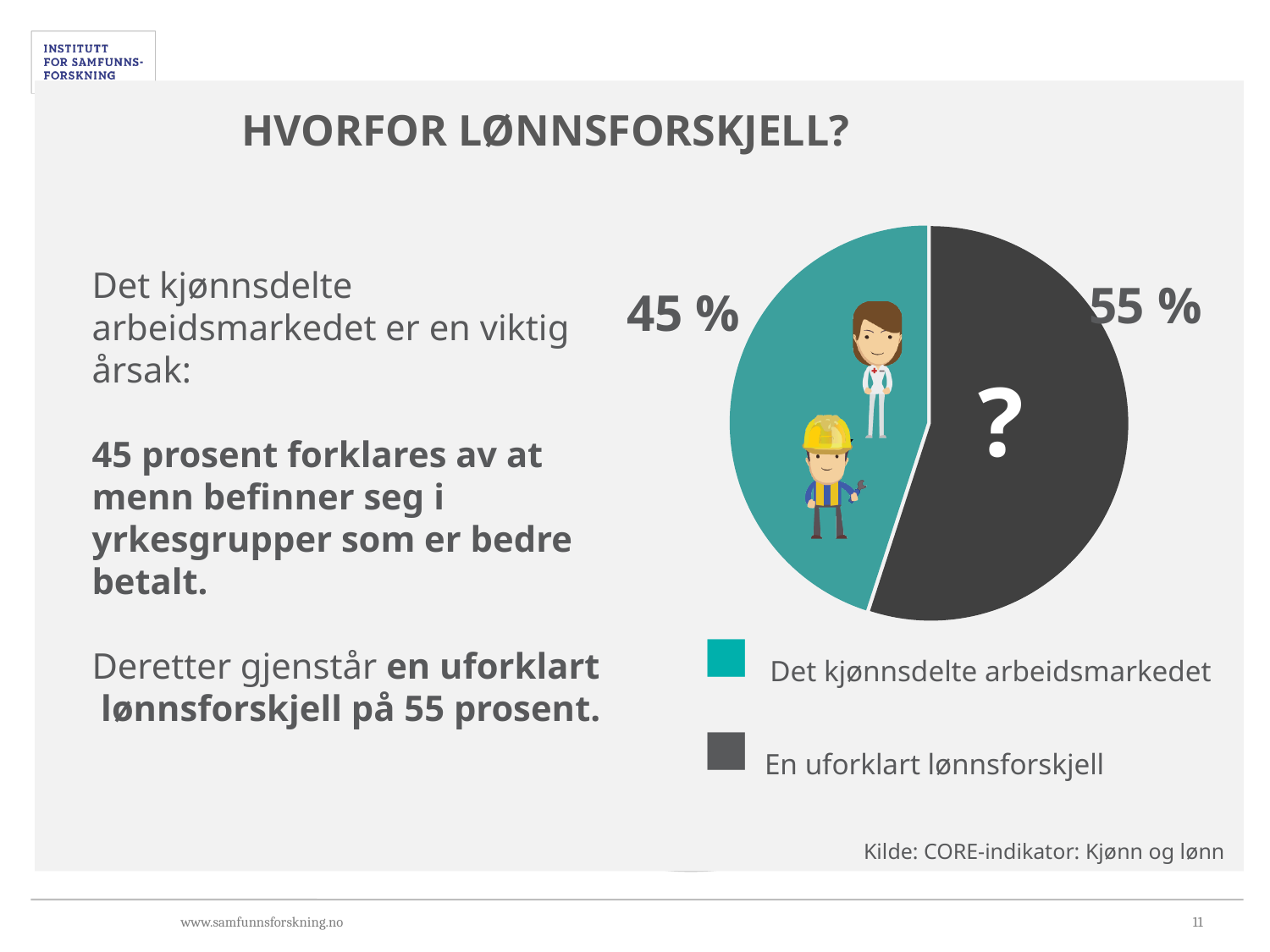
How many slices does the pie chart have? 2 Which slice of the pie is the smallest? Det kjønnsdelte arbeidsmarkedet What is the difference in percentage points between the "En uforklart lønnsforskjell" slice and the "Det kjønnsdelte arbeidsmarkedet" slice? 10 percentage points What is the source cited below the chart? Kilde: CORE-indikator: Kjønn og lønn What share of the pie does "Det kjønnsdelte arbeidsmarkedet" account for? 45 % Which slice of the pie is the largest? En uforklart lønnsforskjell What kind of chart is shown on the slide? pie chart What colour is the slice for "Det kjønnsdelte arbeidsmarkedet"? teal What share of the pie does "En uforklart lønnsforskjell" account for? 55 % Which is larger: the slice for "Det kjønnsdelte arbeidsmarkedet" or the slice for "En uforklart lønnsforskjell"? En uforklart lønnsforskjell How many entries does the legend list? 2